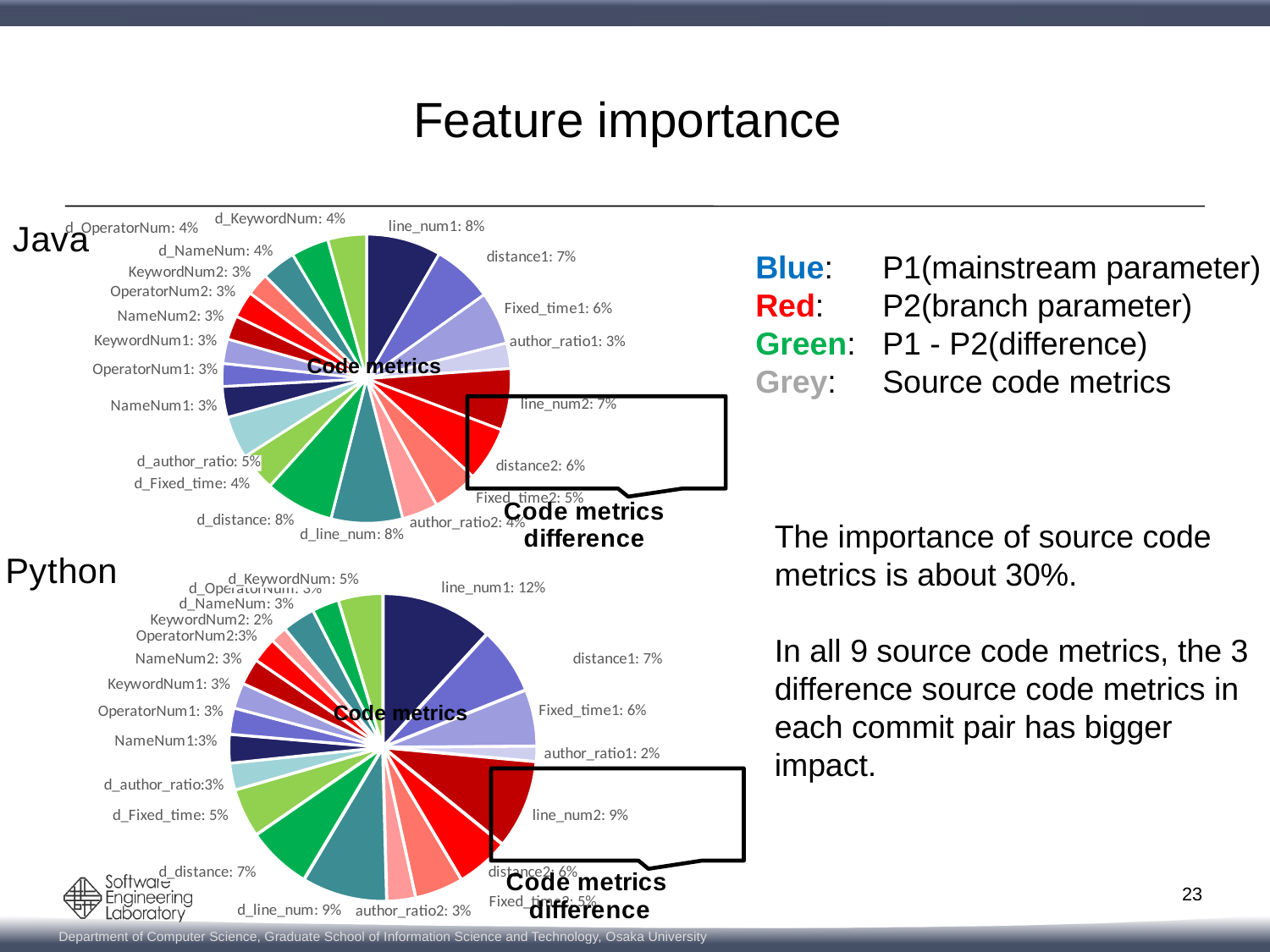
In the Java chart, what is the value for author_ratio1? 3% In the Python chart, what is the value for line_num2? 9% In the Python chart, what is the difference between line_num1 and line_num2? 3% What type of chart is used for the Java feature importance? Pie chart In the Java chart, what is the difference between d_line_num and d_Fixed_time? 4% In the Python chart, which slice is the largest? line_num1 In the Java chart, what share does line_num1 have? 8% In the Java chart, what is the value for d_distance? 8% According to the legend text on the slide, what does the green colour represent? P1 - P2(difference) In the Python chart, what is the value for d_KeywordNum? 5% In the Java chart, which is larger, distance1 or Fixed_time1? distance1 In the Python chart, what share does line_num1 have? 12%